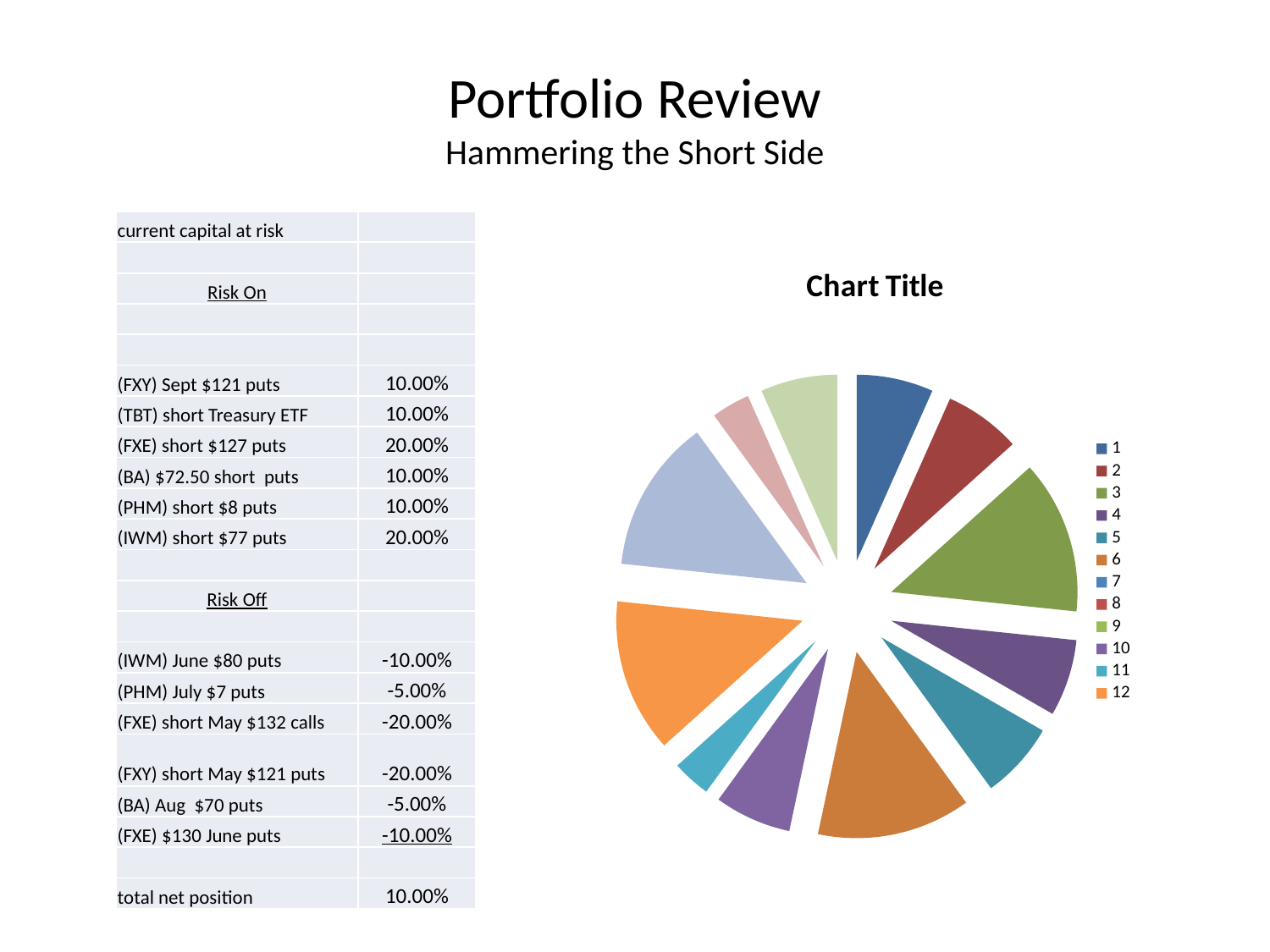
How many entries does the legend of the pie chart list? 12 How many slices does the pie chart have? 12 In the pie chart, which slice is larger, slice 3 or slice 1? 3 What is the title of the pie chart? Chart Title What are the labels of the first and last entries in the pie chart's legend? 1 and 12 What kind of chart is shown on the slide? pie chart In the pie chart, which slice is larger, slice 11 or slice 6? 6